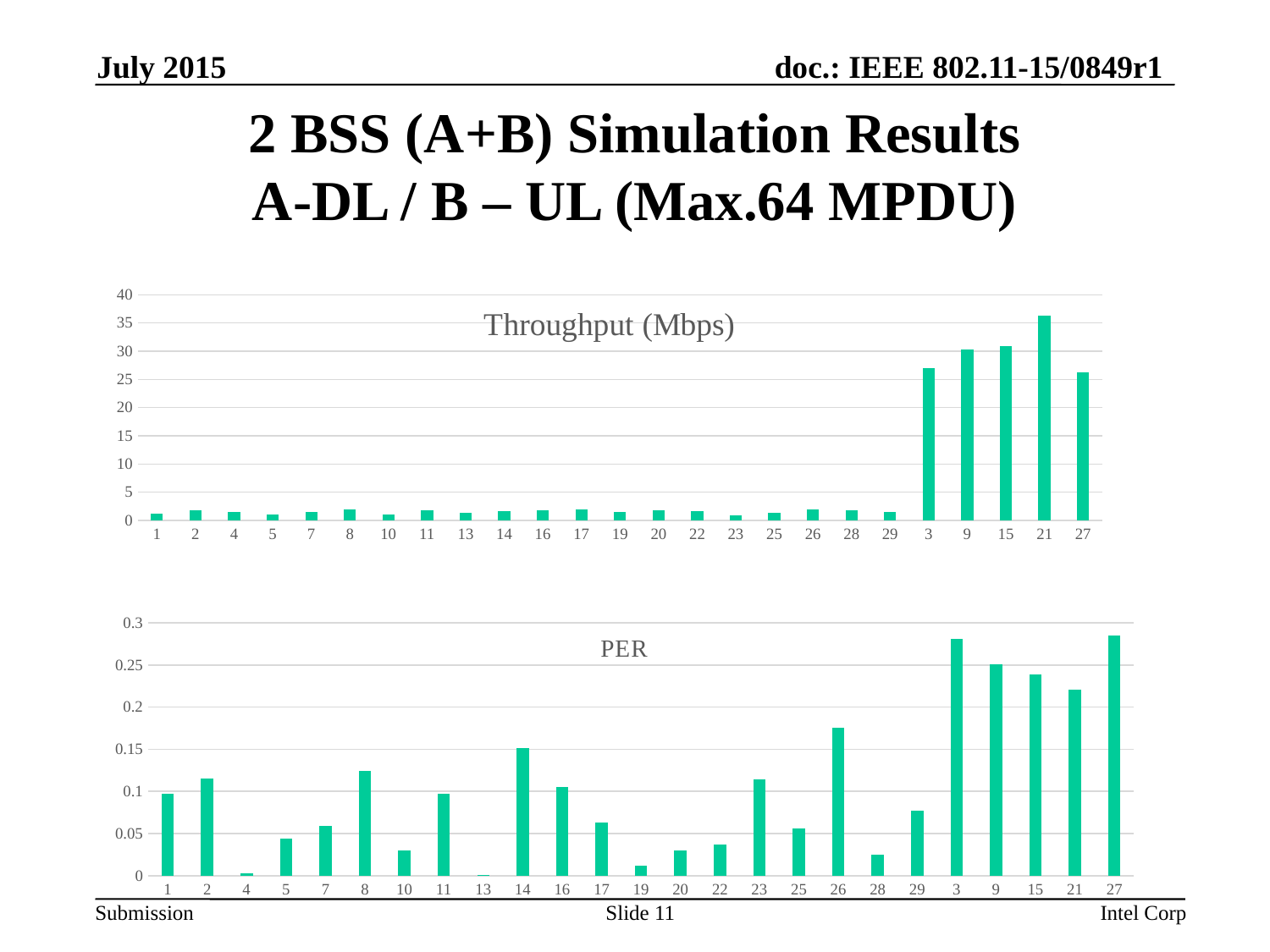
In the PER chart, is the value for category 21 greater or less than 0.25? less In the Throughput (Mbps) chart, which category has the highest throughput? 21 In the PER chart, is the value for category 8 greater or less than 0.1? greater In the PER chart, is the value for category 26 greater or less than 0.15? greater How many categories are shown on the x axis of the Throughput (Mbps) chart? 25 What kind of chart is the Throughput (Mbps) chart? bar chart What is the title of the top chart on the slide? Throughput (Mbps) In the Throughput (Mbps) chart, which has the larger value, category 15 or category 1? 15 In the PER chart, which has the larger value, category 26 or category 23? 26